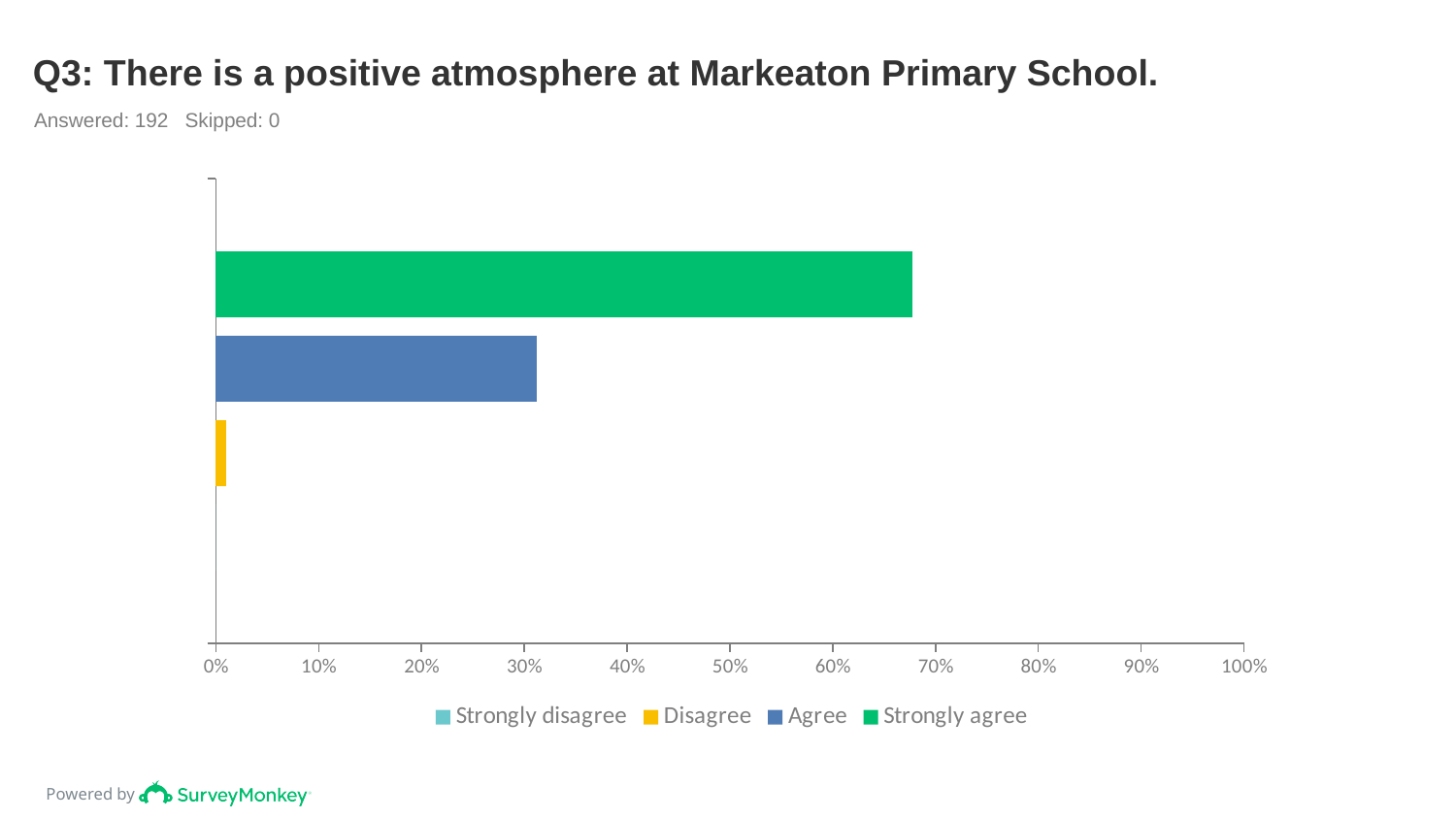
Is the value for Disagree greater or less than 10%? less Which response has the longest bar? Strongly agree How many series does the legend list? 4 What kind of chart is shown on the slide? bar chart What is the title of the chart? Q3: There is a positive atmosphere at Markeaton Primary School. What colour is the Strongly agree bar? green Is the value for Strongly agree greater or less than 70%? less Is the value for Strongly agree greater or less than 60%? greater Which is larger, the value for Disagree or the value for Agree? Agree Which is larger, the value for Agree or the value for Strongly agree? Strongly agree